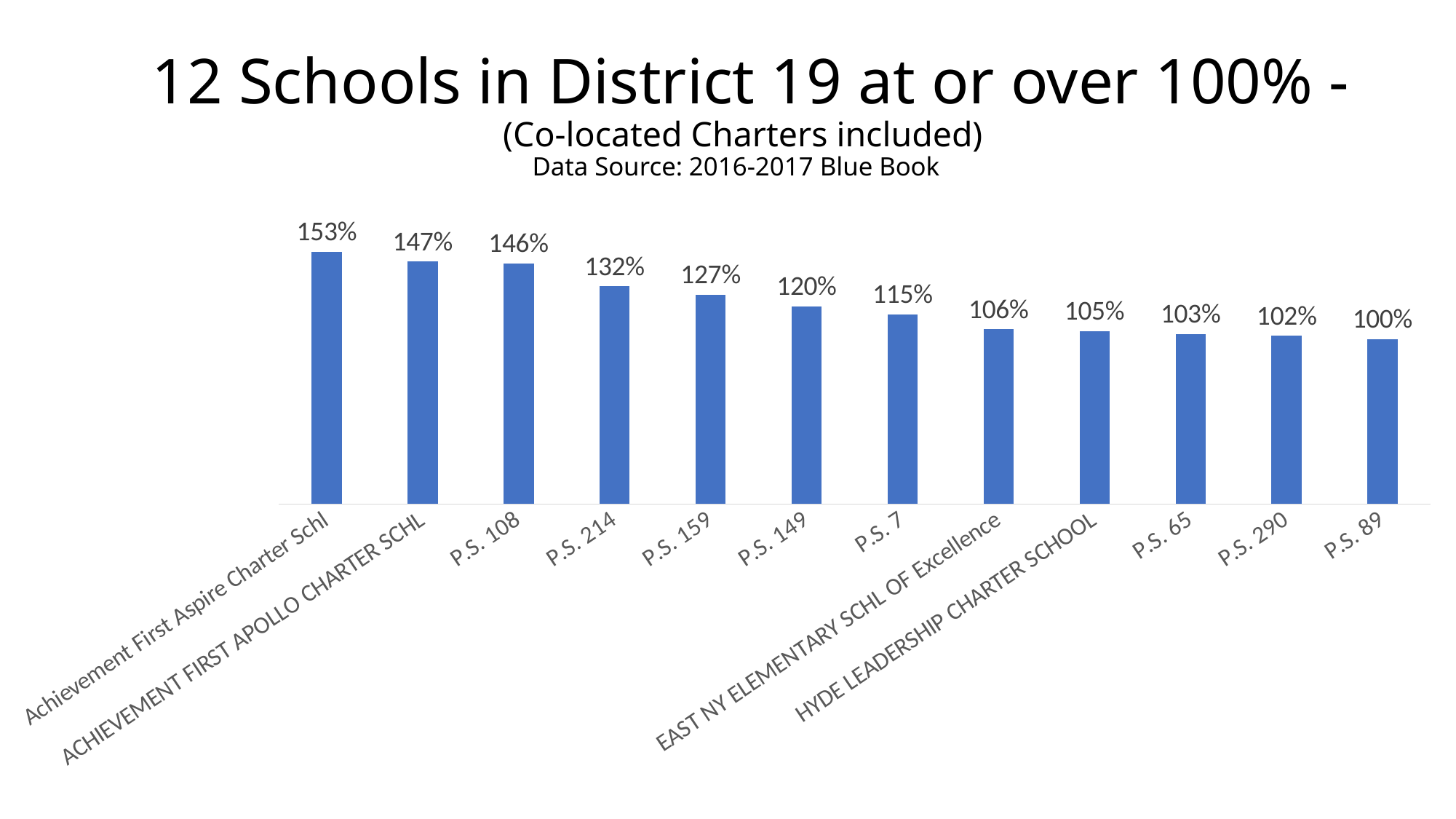
How many schools are shown in the chart? 12 Which school has the lowest value? P.S. 89 Do the values rise or fall from left to right along the x axis? Fall What data source is named in the chart title? 2016-2017 Blue Book What is the value for HYDE LEADERSHIP CHARTER SCHOOL? 105% What is the difference between the values for P.S. 108 and P.S. 149? 26% What is the value for P.S. 159? 127% What kind of chart is shown on the slide? Bar chart What is the difference between the values for ACHIEVEMENT FIRST APOLLO CHARTER SCHL and P.S. 7? 32% What is the value for P.S. 214? 132% Which school has the highest value? Achievement First Aspire Charter Schl Which is larger, the value for P.S. 65 or the value for EAST NY ELEMENTARY SCHL OF Excellence? EAST NY ELEMENTARY SCHL OF Excellence